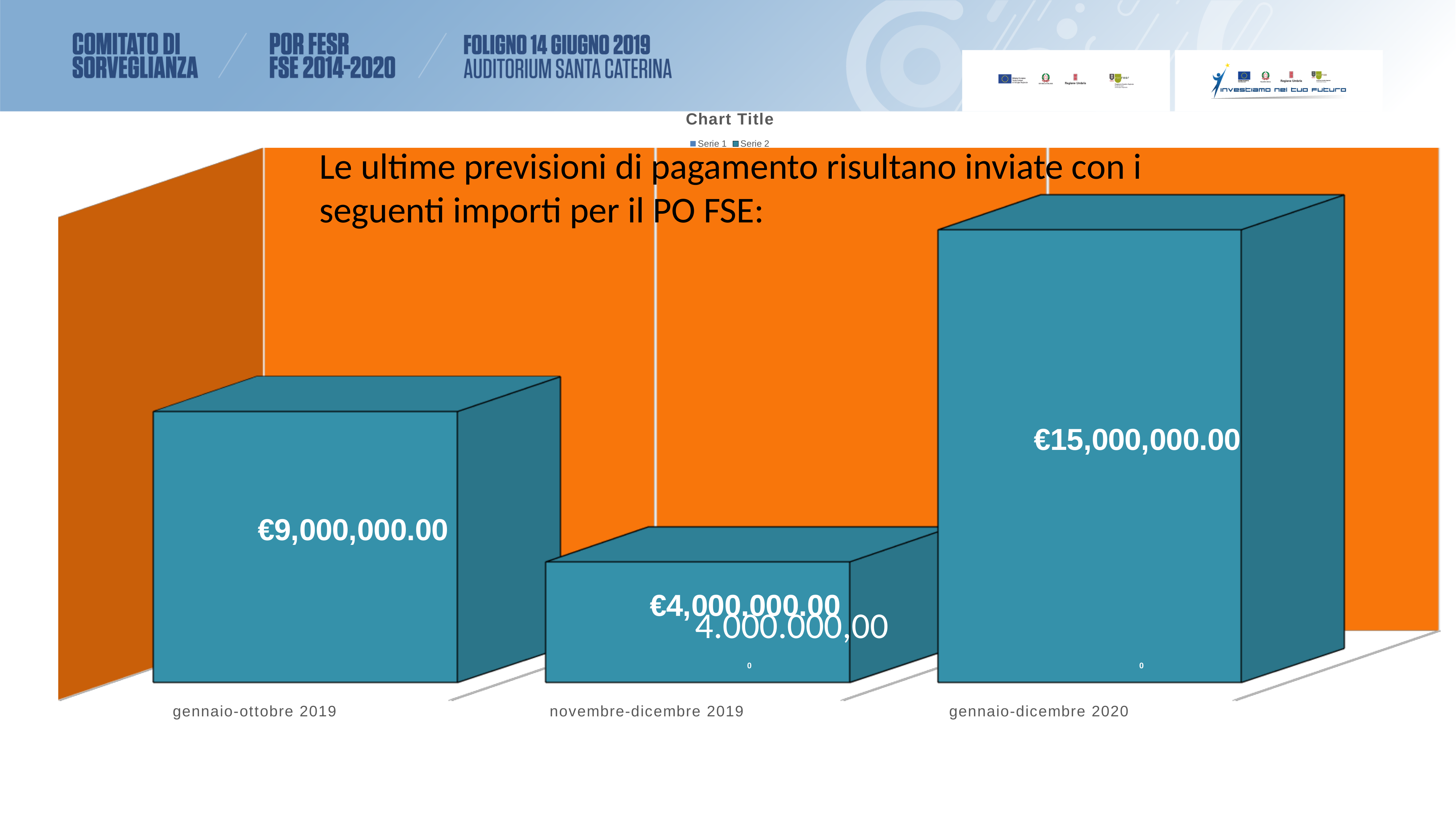
What is the difference between the values for gennaio-ottobre 2019 and novembre-dicembre 2019? €5,000,000.00 Which category has the lowest value? novembre-dicembre 2019 What is the difference between the values for gennaio-dicembre 2020 and gennaio-ottobre 2019? €6,000,000.00 What is the value for gennaio-dicembre 2020? €15,000,000.00 Which category has the highest value? gennaio-dicembre 2020 What is the value for gennaio-ottobre 2019? €9,000,000.00 Which is larger, the value for gennaio-ottobre 2019 or the value for novembre-dicembre 2019? gennaio-ottobre 2019 How many categories are shown on the x axis? 3 What is the value for novembre-dicembre 2019? €4,000,000.00 What is the title of the chart? Chart Title What kind of chart is shown on the slide? bar chart How many series does the legend list? 2